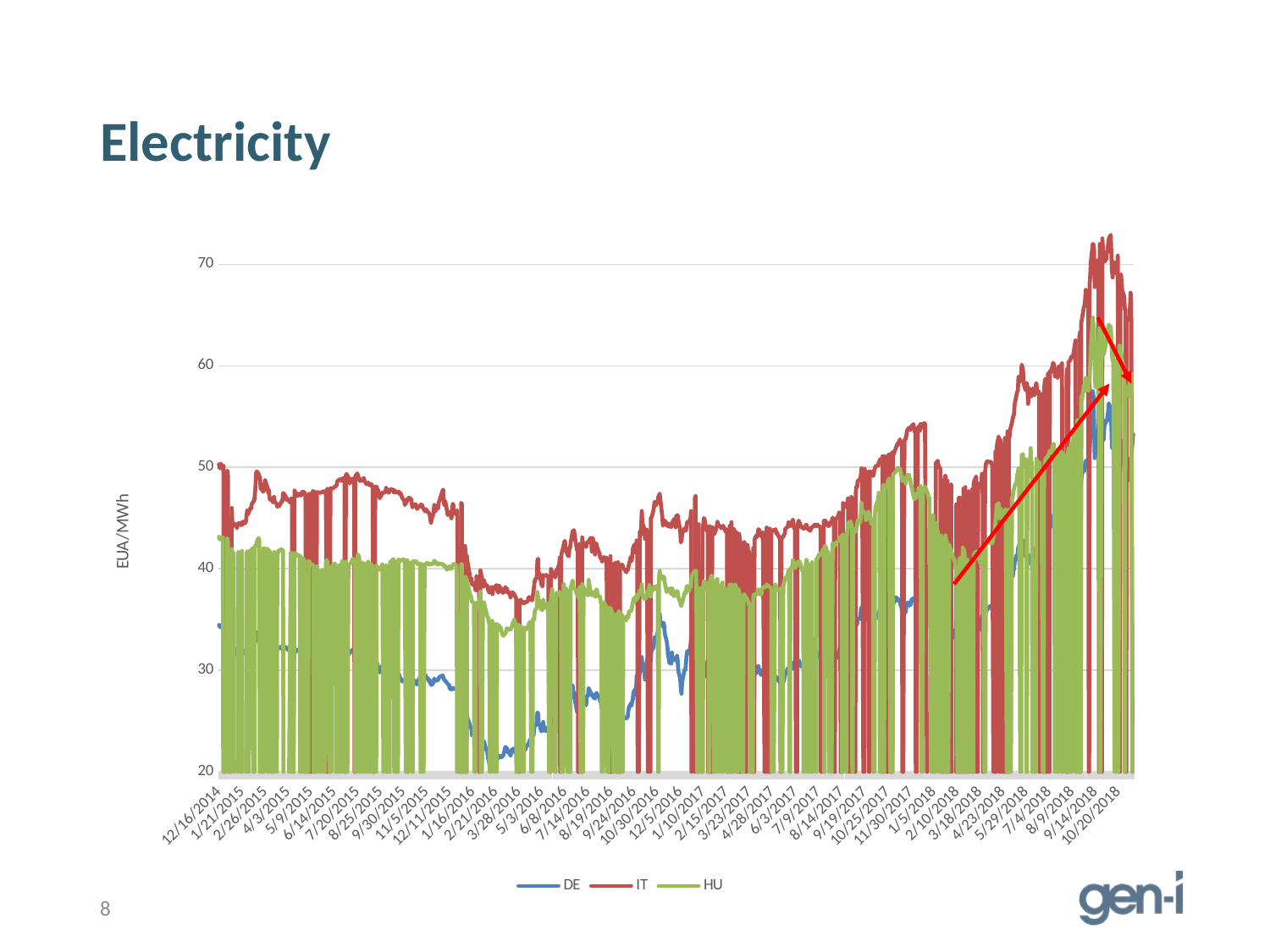
How many series does the legend list? 3 Is the value for DE at 12/16/2014 greater or less than 40? less What is the title of the chart on the slide? Electricity What kind of chart is shown on the slide? line chart At 12/16/2014, which series has the larger value, IT or DE? IT What is the label on the vertical axis? EUA/MWh Is the value for IT around 7/20/2015 greater or less than 40? greater Which series has the lowest values in early 2016? DE Is the value for IT around 10/20/2018 greater or less than 60? greater Which series reaches the highest value on the chart? IT Does the DE series rise or fall from early 2016 to late 2018? rise